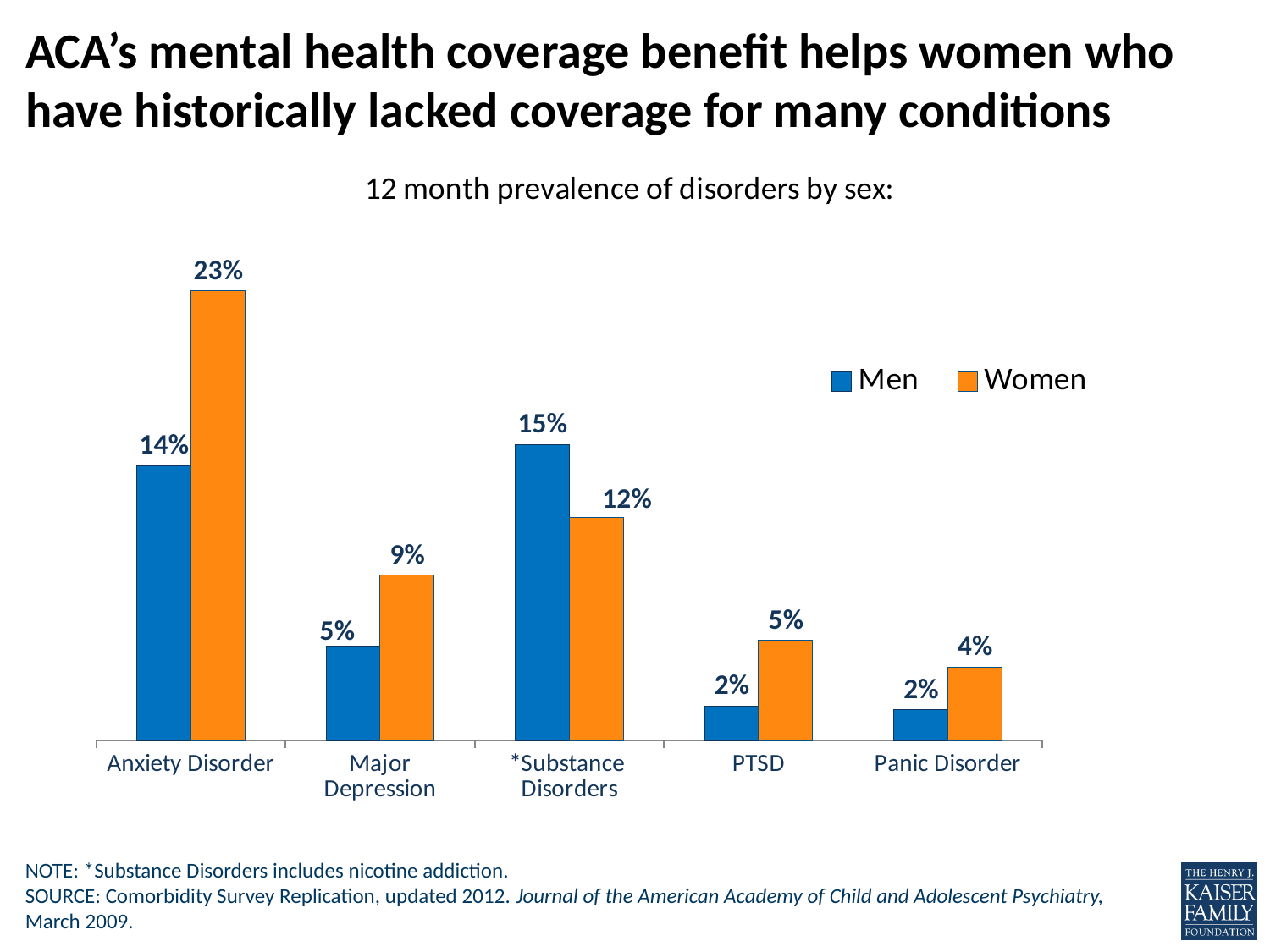
For Substance Disorders, which is larger: the value for men or the value for women? Men What is the difference between the men's and women's values for Substance Disorders? 3% What is the difference between the women's and men's values for Anxiety Disorder? 9% What is the value for Major Depression among women? 9% How many series does the legend list? 2 What is the 12 month prevalence of Anxiety Disorder among women? 23% What is the value for PTSD among men? 2% Which disorder has the highest prevalence among women? Anxiety Disorder How many disorders are shown on the x axis? 5 Which disorder has the lowest prevalence among women? Panic Disorder What is the 12 month prevalence of Substance Disorders among men? 15% What kind of chart is shown on the slide? Bar chart